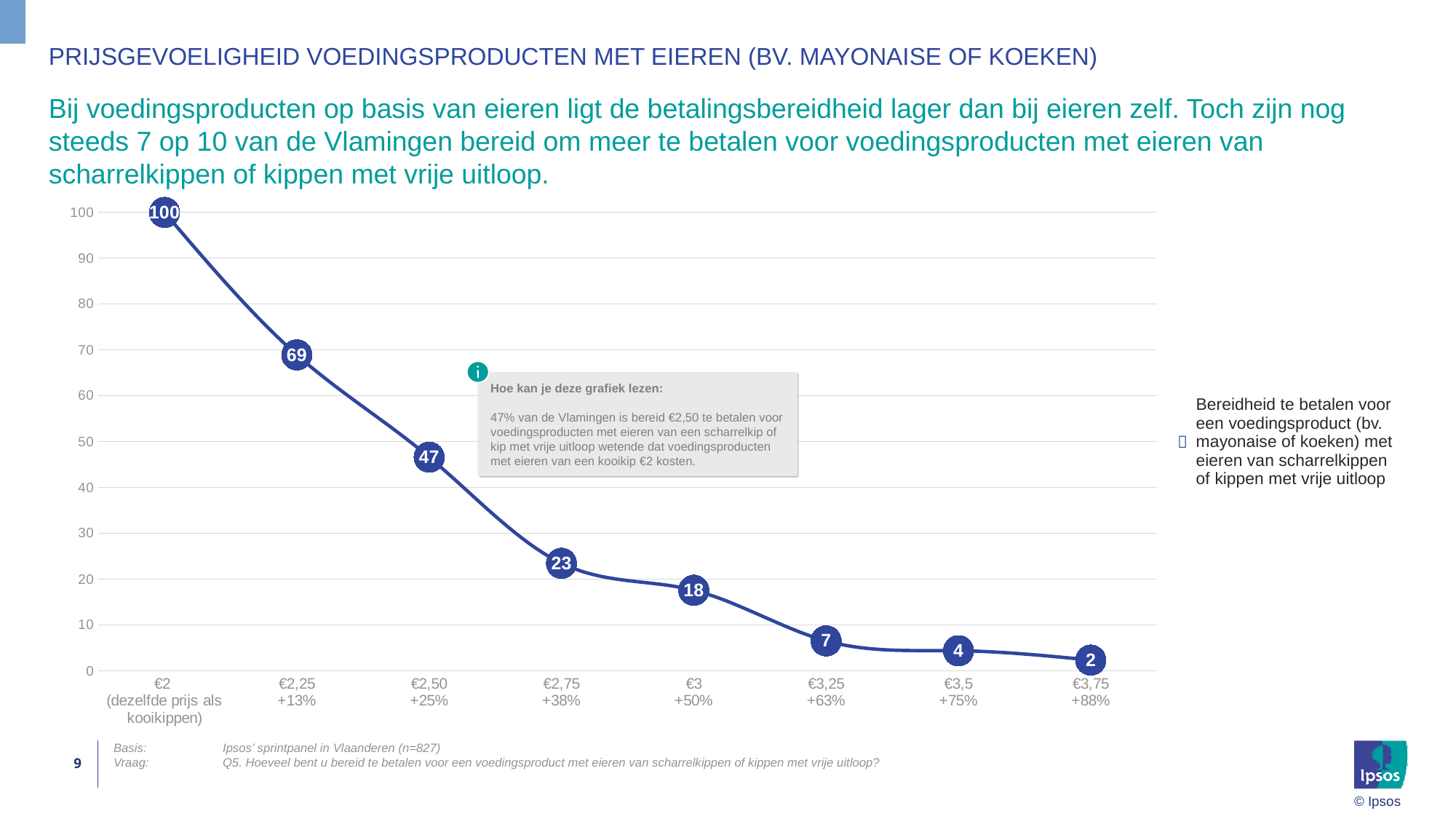
What is the difference between the values at €2,75 and €3? 5 How many price points are plotted on the line? 8 What is the difference between the values at €2,25 and €2,50? 22 What kind of chart is shown on the slide? Line chart What is the value plotted at €2,50 (+25%)? 47 What is the value plotted at €2,25 (+13%)? 69 What is the value plotted at €3,75 (+88%)? 2 Do the values rise or fall as the price increases along the x axis? Fall Which is larger, the value at €3,25 or the value at €3,5? €3,25 What is the value plotted at €3 (+50%)? 18 Which price point has the lowest value? €3,75 (+88%) Which price point has the highest value? €2 (dezelfde prijs als kooikippen)